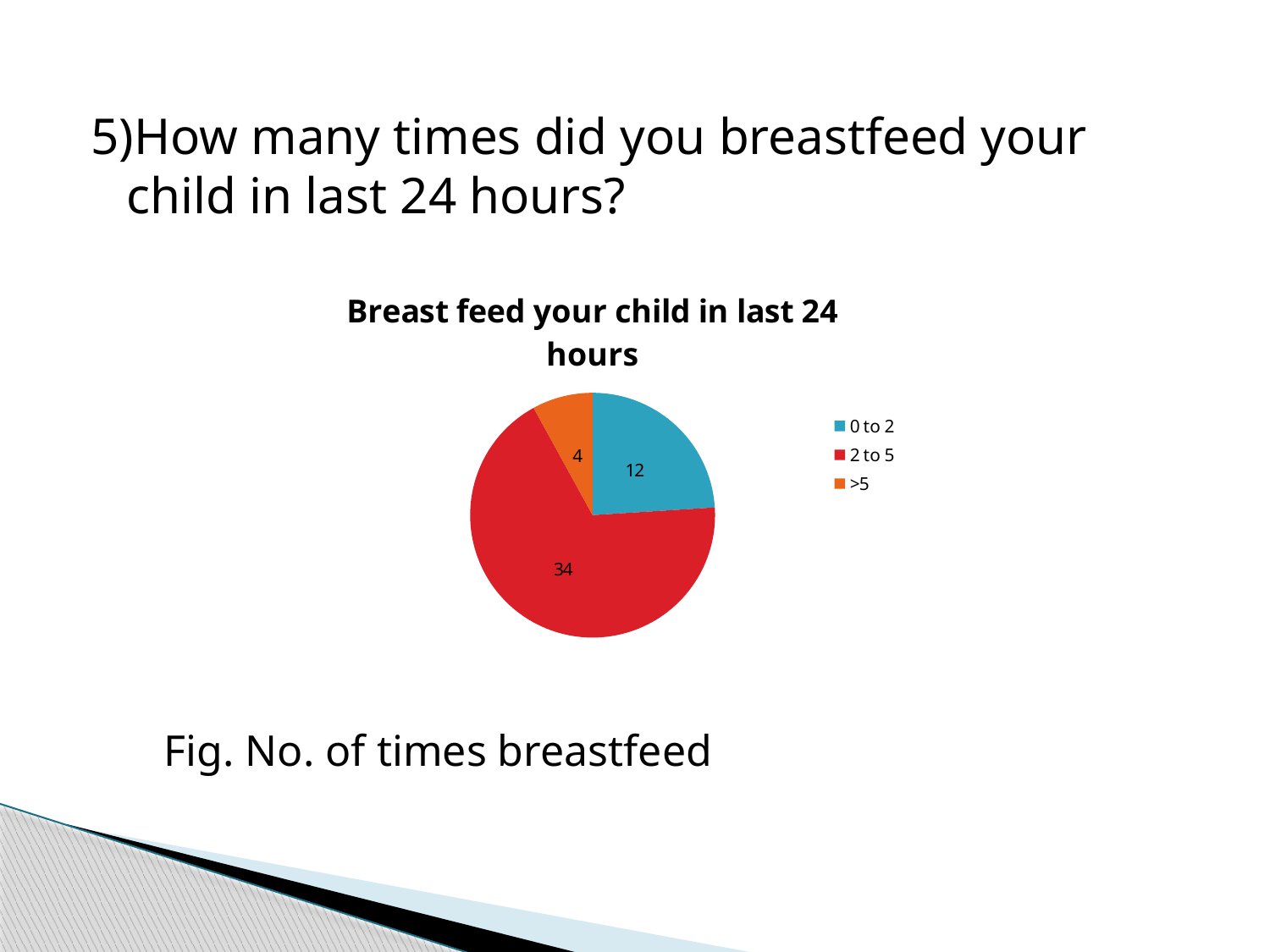
How many categories does the pie chart show? 3 What is the value for the ">5" category in the pie chart? 4 What is the value for the "2 to 5" category in the pie chart? 34 What share of the pie does the "2 to 5" slice represent? 68% Which category has the smallest slice in the pie chart? >5 What is the difference between the values for "2 to 5" and "0 to 2"? 22 What is the title of the pie chart? Breast feed your child in last 24 hours Which category has the largest slice in the pie chart? 2 to 5 What is the value for the "0 to 2" category in the pie chart? 12 What is the total of all the slices in the pie chart? 50 Which is larger, the value for "0 to 2" or the value for ">5"? 0 to 2 What kind of chart is shown on the slide? Pie chart